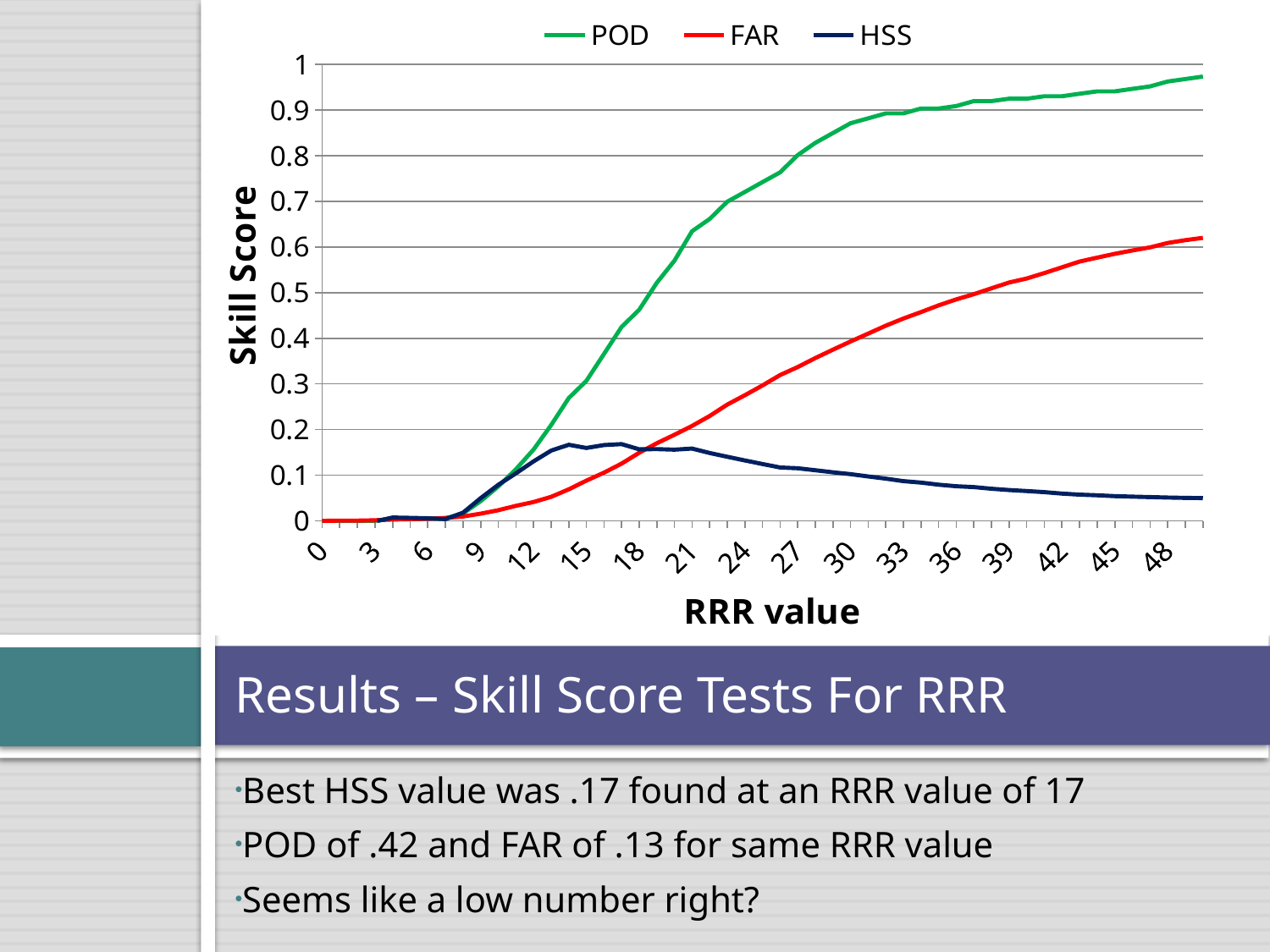
At an RRR value of 30, which series has the larger value, POD or FAR? POD Does the POD series rise or fall as the RRR value increases? rise What is the title of the x axis? RRR value How many series does the legend list? 3 Is the FAR value at an RRR value of 48 greater or less than 0.5? greater Which series reaches the highest skill score on the chart? POD What kind of chart is shown on the slide? line chart Is the POD value at an RRR value of 24 greater or less than 0.6? greater Is the HSS value at an RRR value of 48 greater or less than 0.1? less Does the FAR series rise or fall as the RRR value increases? rise What are the series names listed in the legend? POD, FAR, HSS